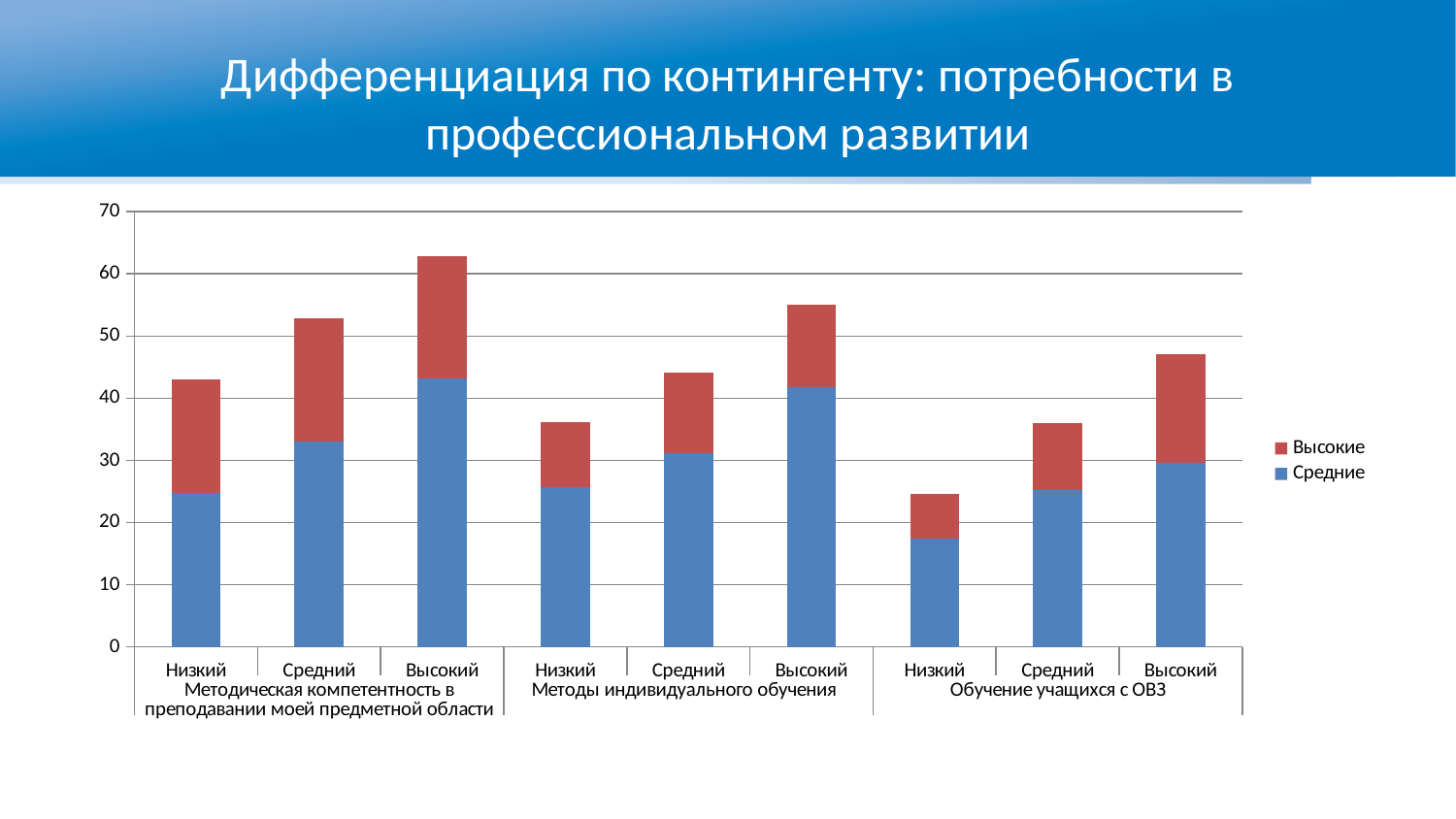
Which series is shown in red in the legend? Высокие Is the total value for Низкий in the group Обучение учащихся с ОВЗ greater or less than 30? less What kind of chart is shown on the slide? Stacked bar chart Within each group, do the total values rise or fall from Низкий to Высокий? rise Which bar has the highest total value? Высокий (Методическая компетентность в преподавании моей предметной области) Which bar has the lowest total value? Низкий (Обучение учащихся с ОВЗ) Is the total value for Средний in the group Методы индивидуального обучения greater or less than 40? greater What is the title of the slide? Дифференциация по контингенту: потребности в профессиональном развитии Which is larger: the total for Высокий in Методы индивидуального обучения or the total for Высокий in Обучение учащихся с ОВЗ? Высокий in Методы индивидуального обучения Is the total value for Высокий in the group Методическая компетентность в преподавании моей предметной области greater or less than 60? greater How many series does the legend list? 2 How many bars are plotted in the chart? 9